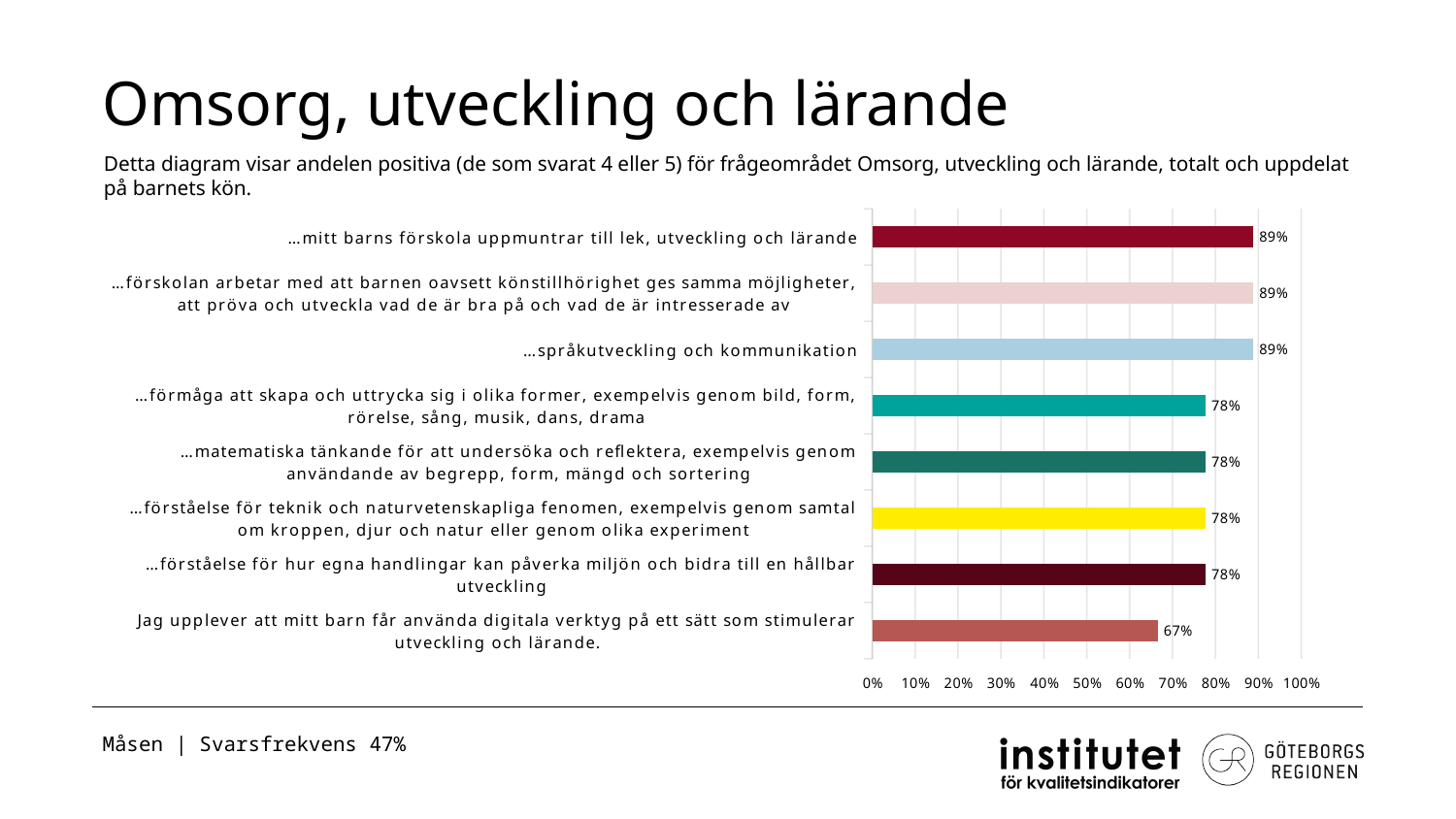
Which is larger: the value for "…språkutveckling och kommunikation" or the value for "…förståelse för teknik och naturvetenskapliga fenomen, exempelvis genom samtal om kroppen, djur och natur eller genom olika experiment"? …språkutveckling och kommunikation How many categories are shown in the chart? 8 What is the difference between the value for "…språkutveckling och kommunikation" and the value for "Jag upplever att mitt barn får använda digitala verktyg på ett sätt som stimulerar utveckling och lärande."? 22 percentage points What is the difference between the value for "…mitt barns förskola uppmuntrar till lek, utveckling och lärande" and the value for "…förmåga att skapa och uttrycka sig i olika former, exempelvis genom bild, form, rörelse, sång, musik, dans, drama"? 11 percentage points What is the title of the slide containing the chart? Omsorg, utveckling och lärande What is the value for "Jag upplever att mitt barn får använda digitala verktyg på ett sätt som stimulerar utveckling och lärande."? 67% Which category has the lowest value? Jag upplever att mitt barn får använda digitala verktyg på ett sätt som stimulerar utveckling och lärande. What is the value for "…förståelse för hur egna handlingar kan påverka miljön och bidra till en hållbar utveckling"? 78% What is the value for "…matematiska tänkande för att undersöka och reflektera, exempelvis genom användande av begrepp, form, mängd och sortering"? 78% What is the value for "…språkutveckling och kommunikation"? 89% What kind of chart is shown on the slide? Bar chart What is the value for "…mitt barns förskola uppmuntrar till lek, utveckling och lärande"? 89%